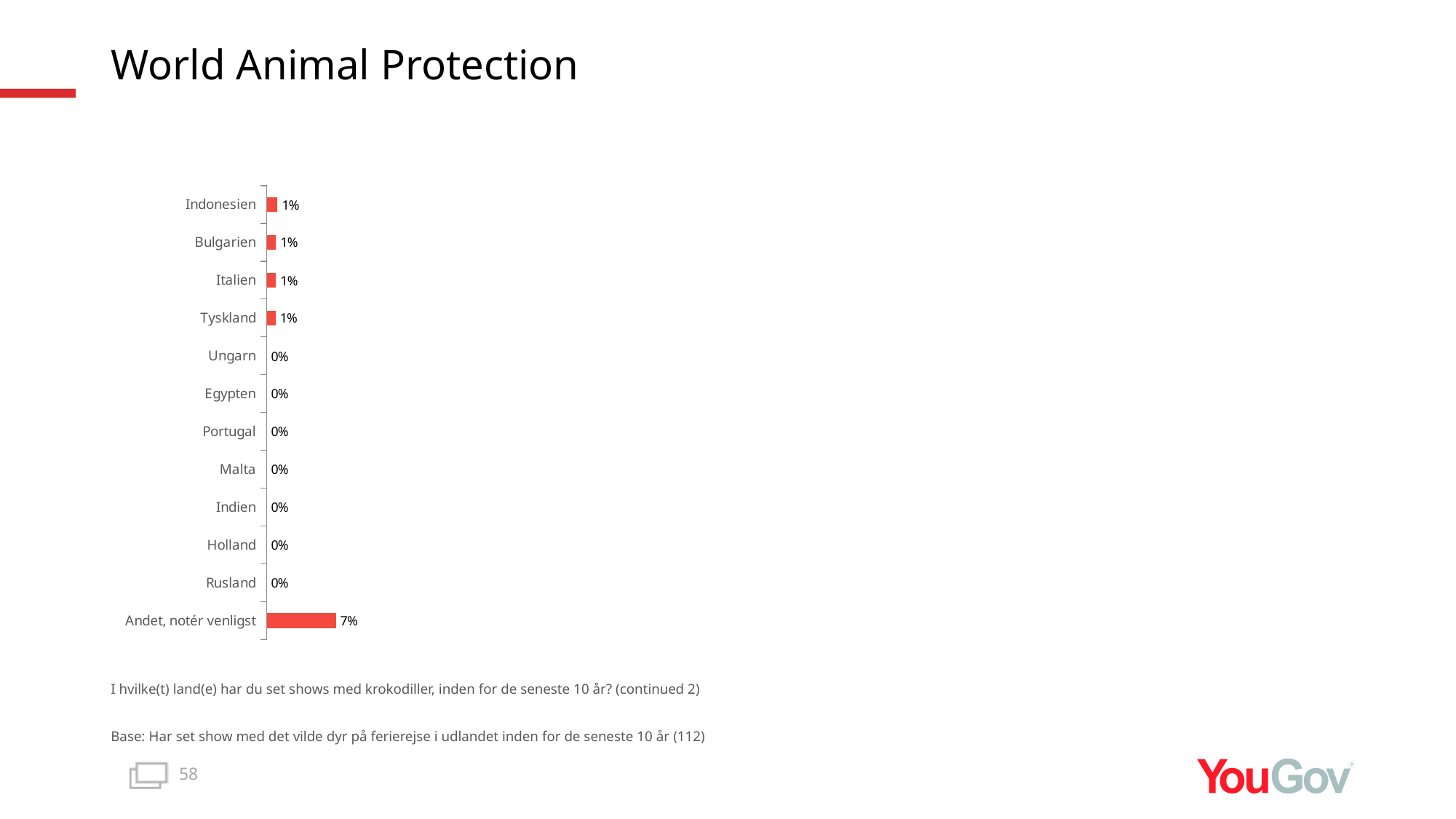
What colour are the bars in the chart? Red What is the difference between the values for Andet, notér venligst and Italien? 6% What is the value for Tyskland? 1% Which category has the highest value? Andet, notér venligst How many categories are shown in the chart? 12 What kind of chart is shown on the slide? Bar chart What is the value for Andet, notér venligst? 7% What is the value for Indonesien? 1% Which is larger, the value for Bulgarien or the value for Rusland? Bulgarien How many categories have a value of 0%? 7 What is the value for Ungarn? 0% What is the value for Holland? 0%